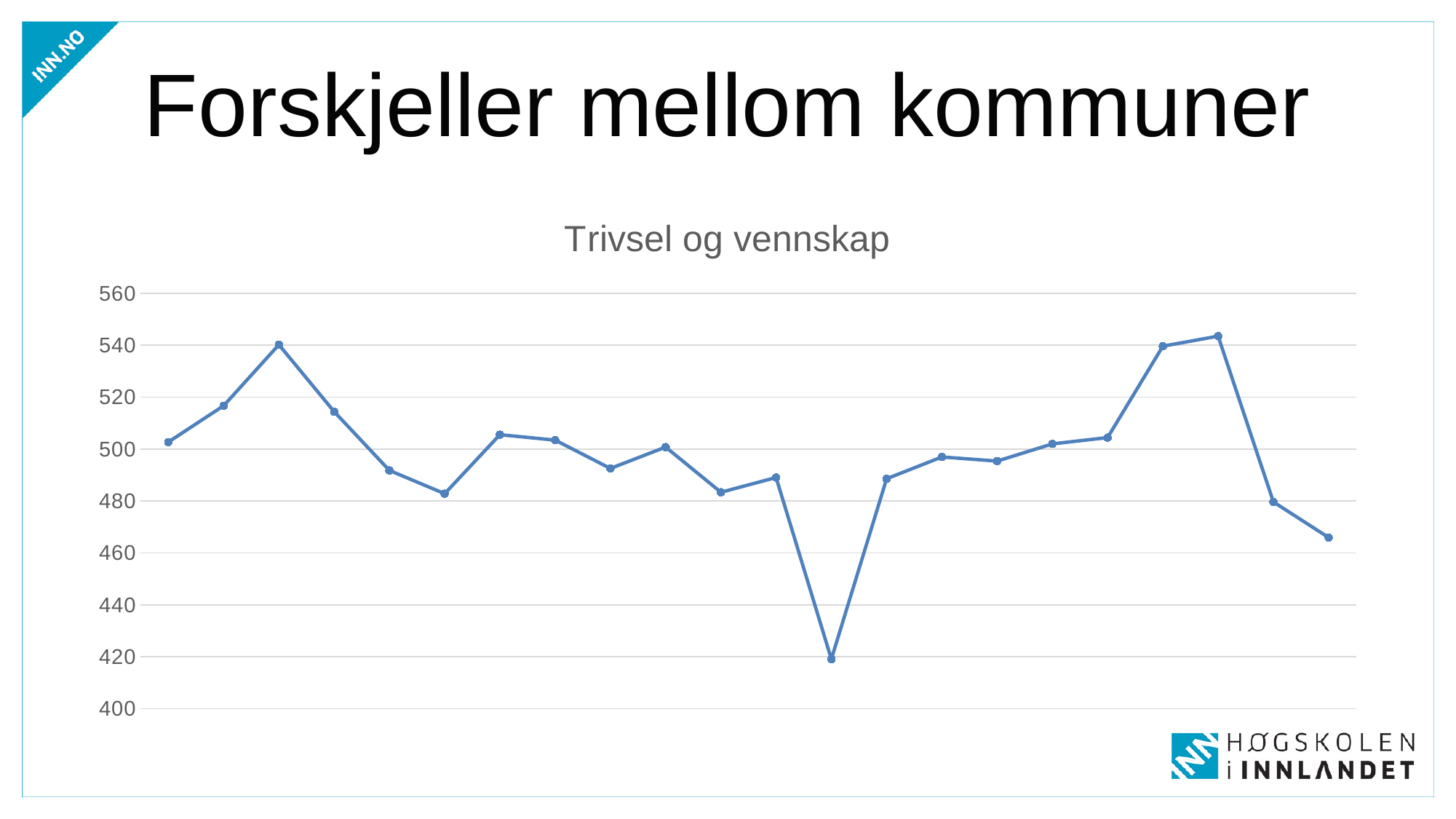
Which is larger, the value of the first data point or the value of the last data point? the first data point What is the title of the chart? Trivsel og vennskap Is the value of the lowest data point greater or less than 440? less Does the line end higher or lower than it starts? lower Is the value of the sixth data point greater or less than 500? less How many data points are plotted on the line? 22 Is the value of the highest data point greater or less than 520? greater What kind of chart is shown on the slide? line chart What is the lowest value shown on the vertical axis? 400